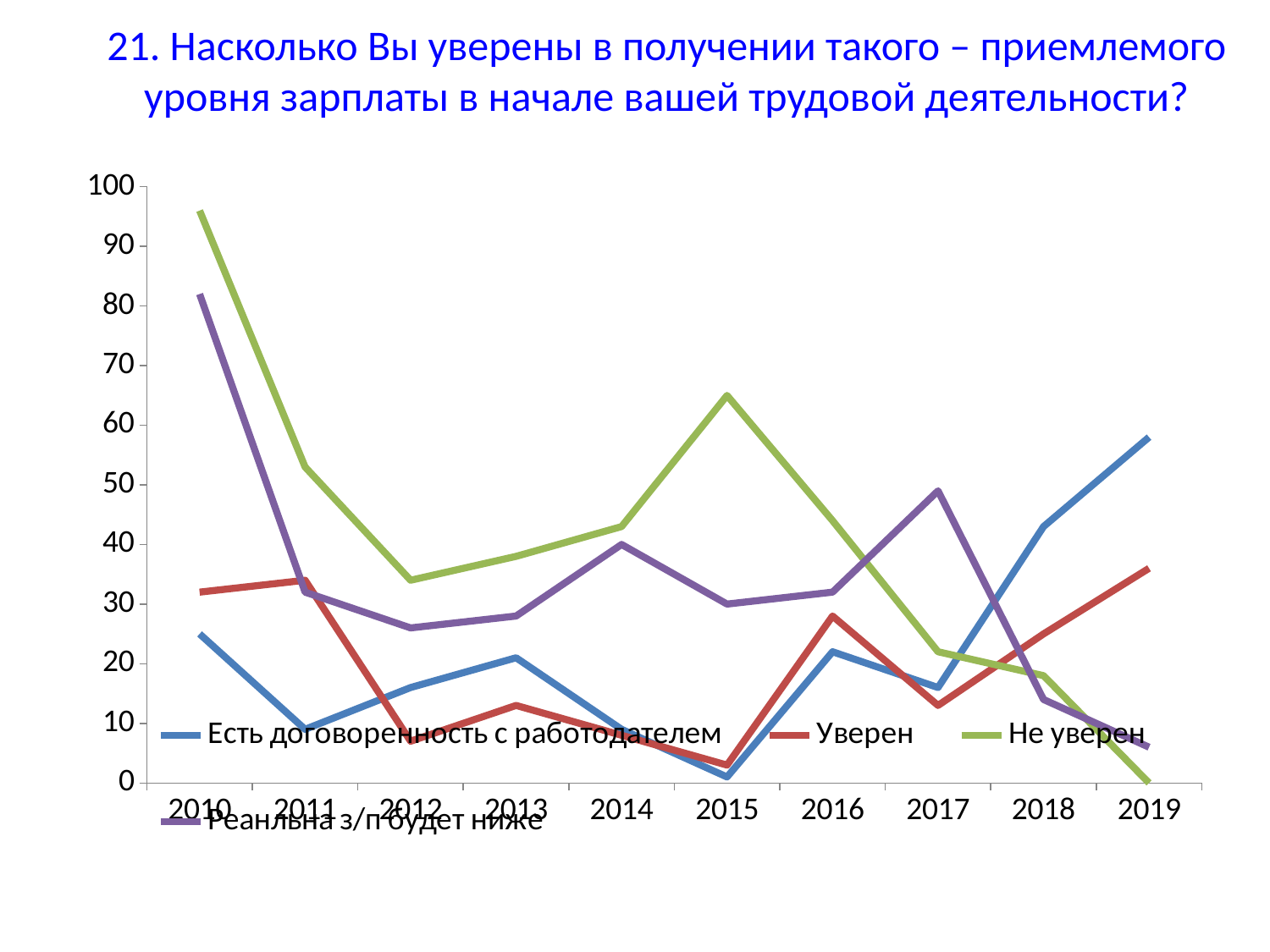
What kind of chart is shown on the slide? line chart Is the value for "Есть договоренность с работодателем" in 2019 greater or less than 50? greater How many series does the legend list? 4 In 2019, which is larger: "Есть договоренность с работодателем" or "Уверен"? Есть договоренность с работодателем Is the value for "Не уверен" in 2010 greater or less than 90? greater In which year is the value for "Не уверен" highest? 2010 Is the value for "Уверен" in 2015 greater or less than 10? less Does the value for "Не уверен" rise or fall from 2016 to 2019? fall In 2017, which is larger: "Реанльна з/п будет ниже" or "Не уверен"? Реанльна з/п будет ниже How many years are shown along the x axis? 10 What is the value for "Не уверен" in 2019? 0